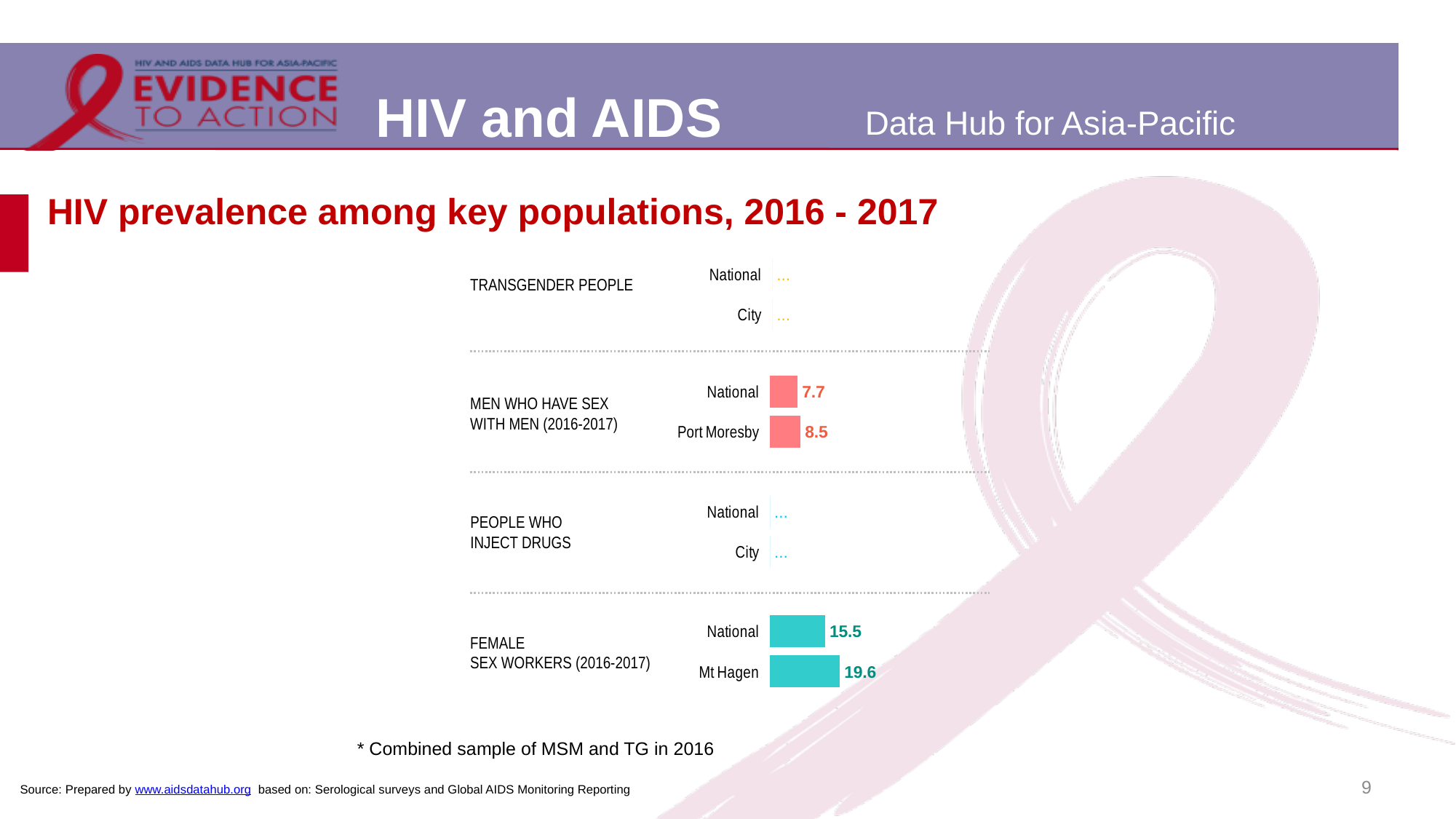
Which is larger: the national HIV prevalence among female sex workers or among men who have sex with men? Female sex workers Which of the plotted values is the lowest? Men who have sex with men, National What is the HIV prevalence among men who have sex with men in Port Moresby? 8.5 What is the national HIV prevalence among female sex workers? 15.5 What is the national HIV prevalence among men who have sex with men? 7.7 What is the difference between the Mt Hagen and national HIV prevalence among female sex workers? 4.1 How many key population groups are listed on the chart? 4 What is the title of the chart? HIV prevalence among key populations, 2016 - 2017 What is the HIV prevalence among female sex workers in Mt Hagen? 19.6 What kind of chart is shown on the slide? Bar chart Which bar shows the highest HIV prevalence value on the chart? Female sex workers, Mt Hagen What is the difference between the Port Moresby and national HIV prevalence among men who have sex with men? 0.8